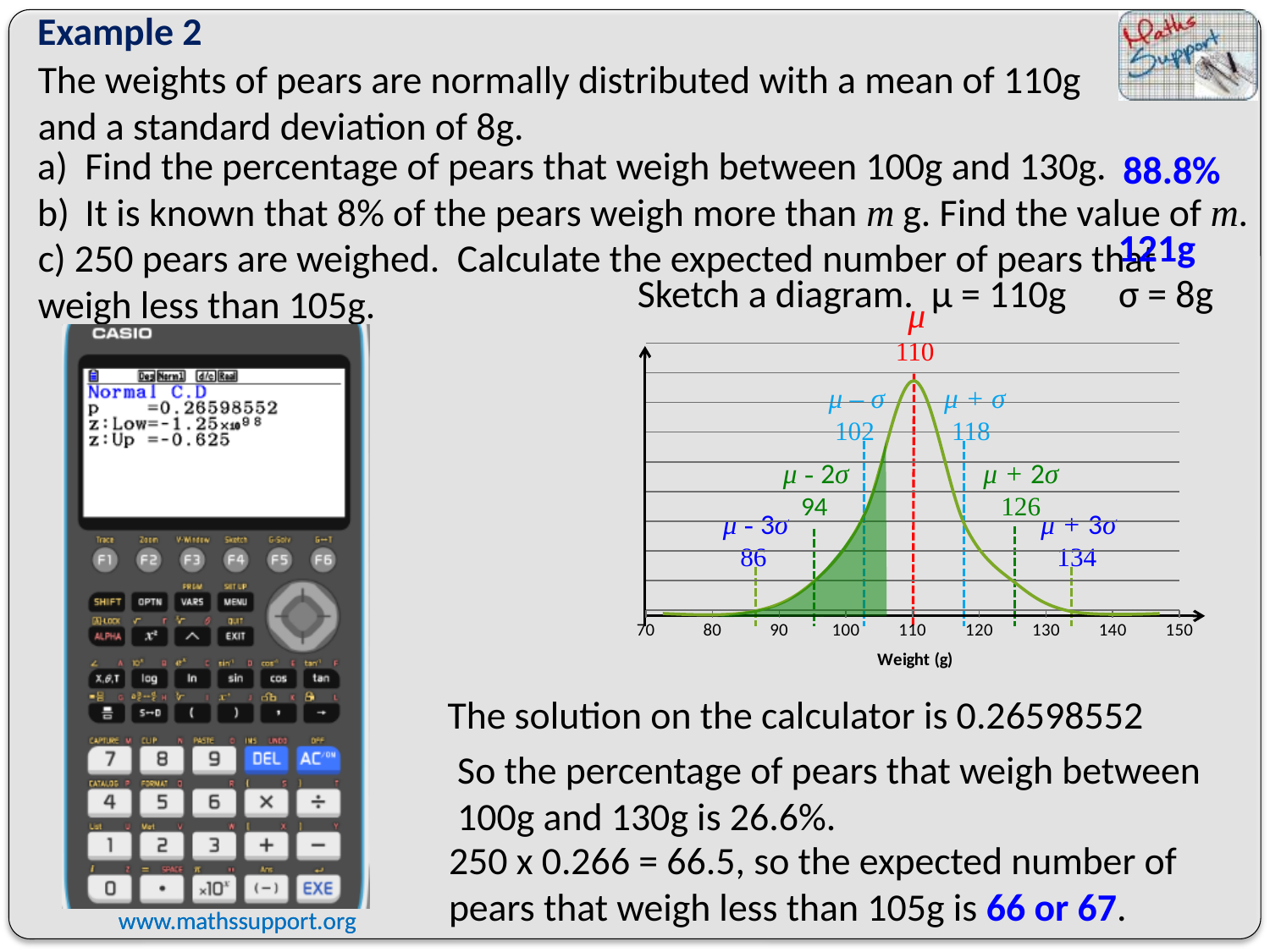
What value is labelled at μ on the chart? 110 What kind of chart is shown on the slide? line chart What is the difference between the values labelled at μ + σ and μ - σ on the chart? 16 What is the title of the horizontal axis of the chart? Weight (g) Does the curve rise or fall as weight increases from 70 to 110? rises What is the lowest tick value shown on the horizontal axis of the chart? 70 Which is larger on the chart, the value at μ + 2σ or the value at μ - 2σ? μ + 2σ What value is labelled at μ + 2σ on the chart? 126 How many labelled points (μ and the σ positions) are marked on the chart? 7 What value is labelled at μ - 3σ on the chart? 86 What value is labelled at μ + σ on the chart? 118 Is the value labelled at μ + 3σ greater or less than 130? greater